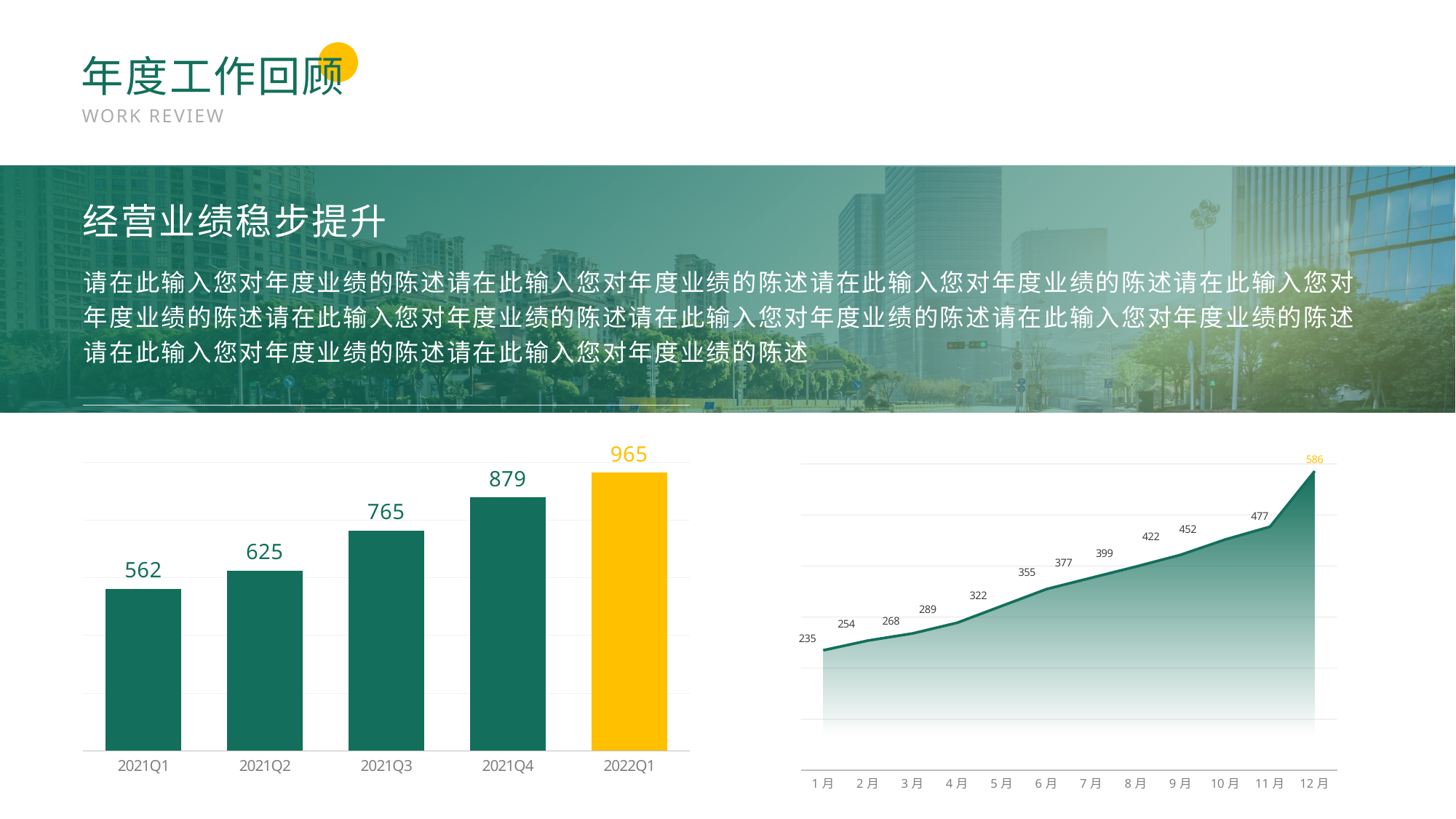
In the bar chart on the left, what is the value for 2021Q3? 765 In the bar chart on the left, which quarter has the lowest value? 2021Q1 In the bar chart on the left, what is the difference between the values for 2022Q1 and 2021Q4? 86 In the bar chart on the left, which quarter has the highest value? 2022Q1 In the area chart on the right, what is the difference between the values for 12月 and 11月? 109 In the area chart on the right, how many months are plotted? 12 In the bar chart on the left, how many bars are there? 5 In the bar chart on the left, do the values rise or fall from 2021Q1 to 2022Q1? rise In the area chart on the right, what is the value for 6月? 355 In the area chart on the right, what is the value for 12月? 586 In the area chart on the right, which month has the lowest value? 1月 In the bar chart on the left, which bar is coloured yellow rather than green? 2022Q1